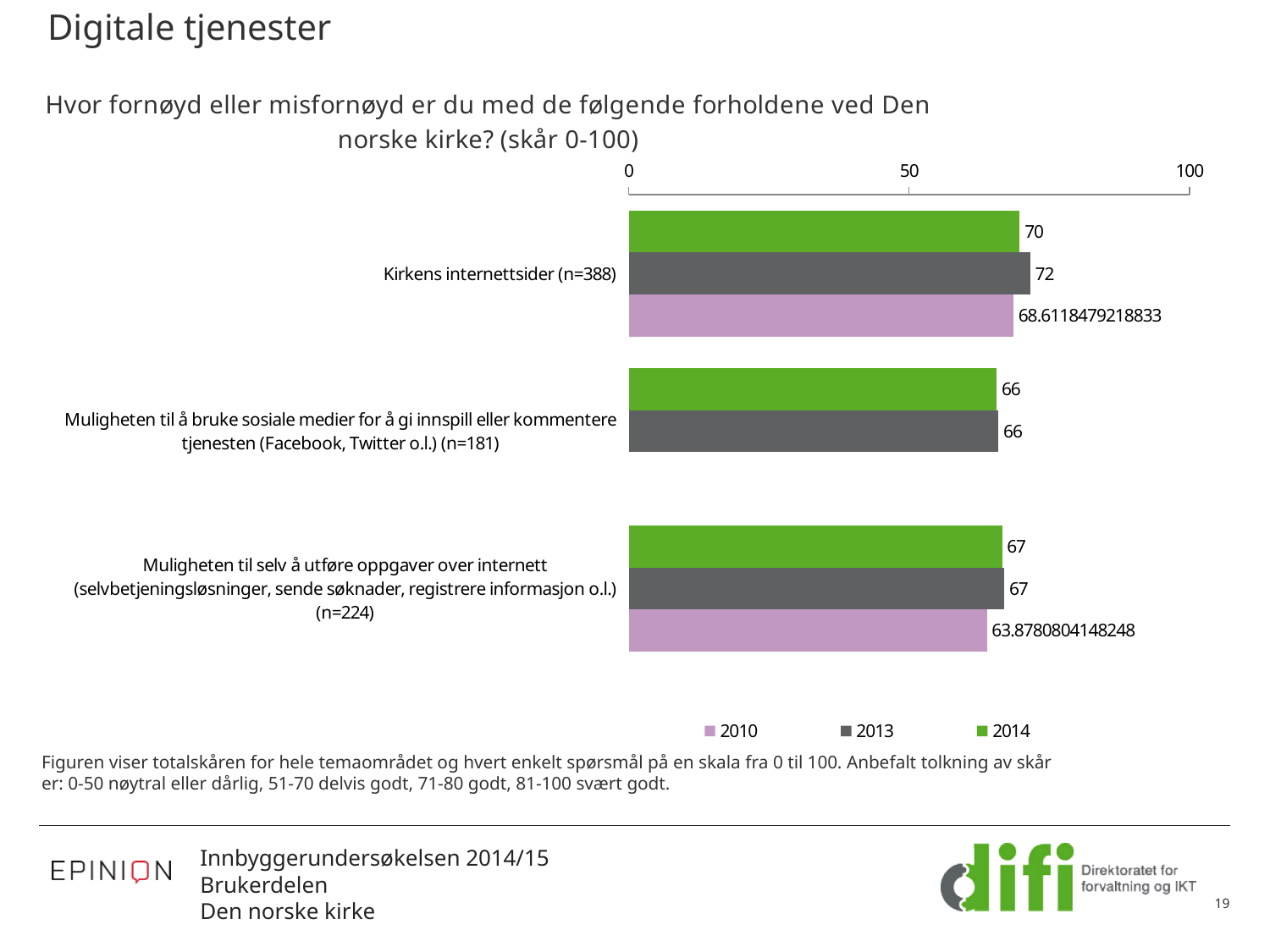
What is the 2014 value for Muligheten til å bruke sosiale medier for å gi innspill eller kommentere tjenesten (Facebook, Twitter o.l.) (n=181)? 66 What is the 2010 value for Kirkens internettsider (n=388)? 68.6118479218833 What is the difference between the 2013 and 2014 values for Kirkens internettsider (n=388)? 2 How many series does the legend list? 3 What is the 2014 value for Kirkens internettsider (n=388)? 70 Which category has the highest 2014 value? Kirkens internettsider (n=388) What kind of chart is shown on the slide? bar chart What is the 2010 value for Muligheten til selv å utføre oppgaver over internett (selvbetjeningsløsninger, sende søknader, registrere informasjon o.l.) (n=224)? 63.8780804148248 Is the 2013 value for Muligheten til selv å utføre oppgaver over internett (n=224) greater or less than 50? greater How many categories are shown on the chart? 3 Which is larger for Kirkens internettsider (n=388): the 2013 value or the 2014 value? 2013 What is the 2013 value for Kirkens internettsider (n=388)? 72